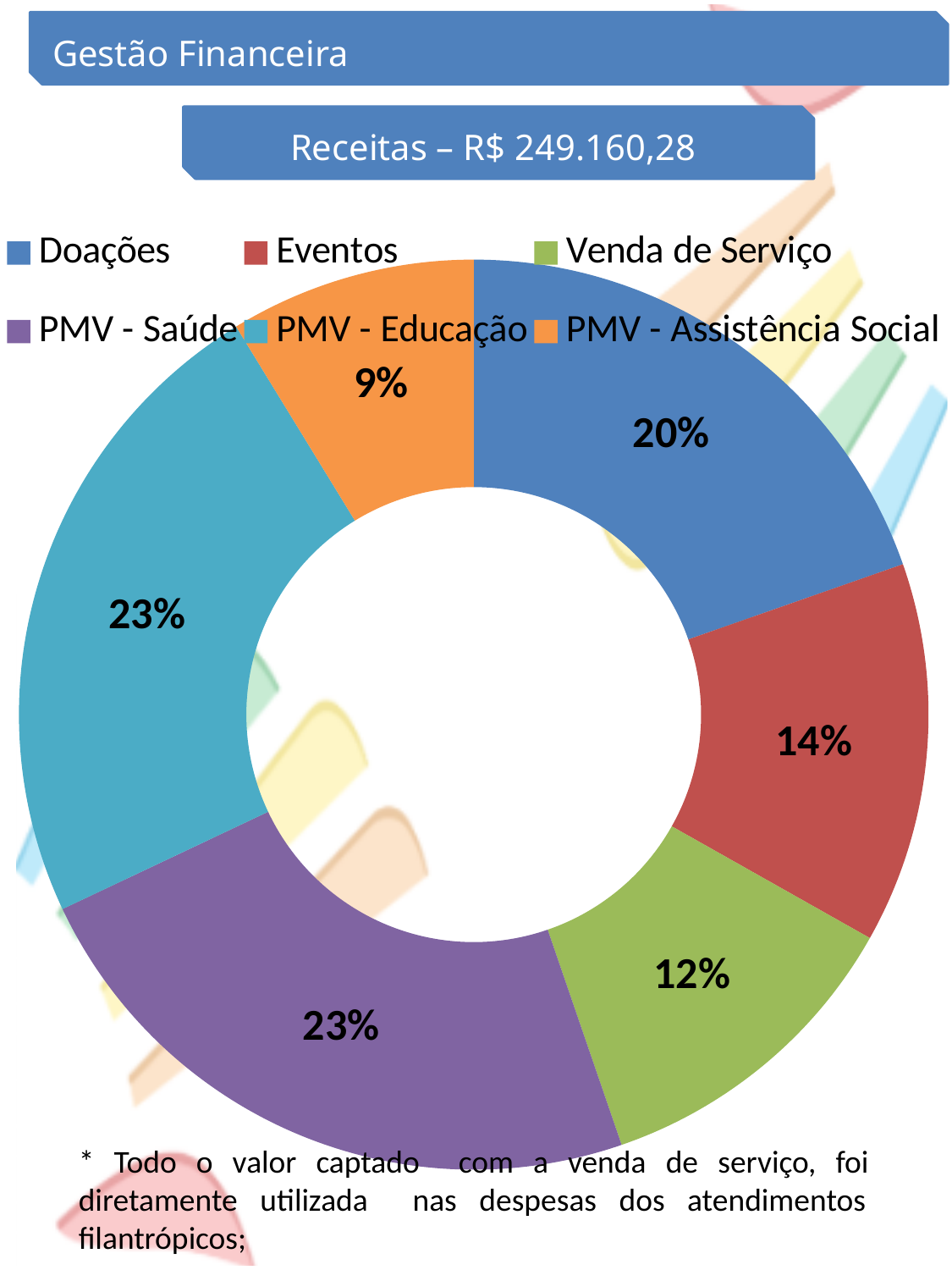
What kind of chart is shown on the slide? Doughnut (pie) chart Which is larger, the share for Doações or the share for Eventos? Doações What share of receipts comes from Eventos? 14% What share of receipts comes from Venda de Serviço? 12% Which colour represents PMV - Educação in the chart? Teal (light blue) How many categories does the chart show? 6 What share of receipts comes from Doações? 20% What share of receipts comes from PMV - Saúde? 23% What is the difference in percentage points between the share for PMV - Educação and the share for Venda de Serviço? 11 percentage points What total revenue amount is stated in the heading above the chart? R$ 249.160,28 Which category has the smallest share of receipts? PMV - Assistência Social What share of receipts comes from PMV - Assistência Social? 9%